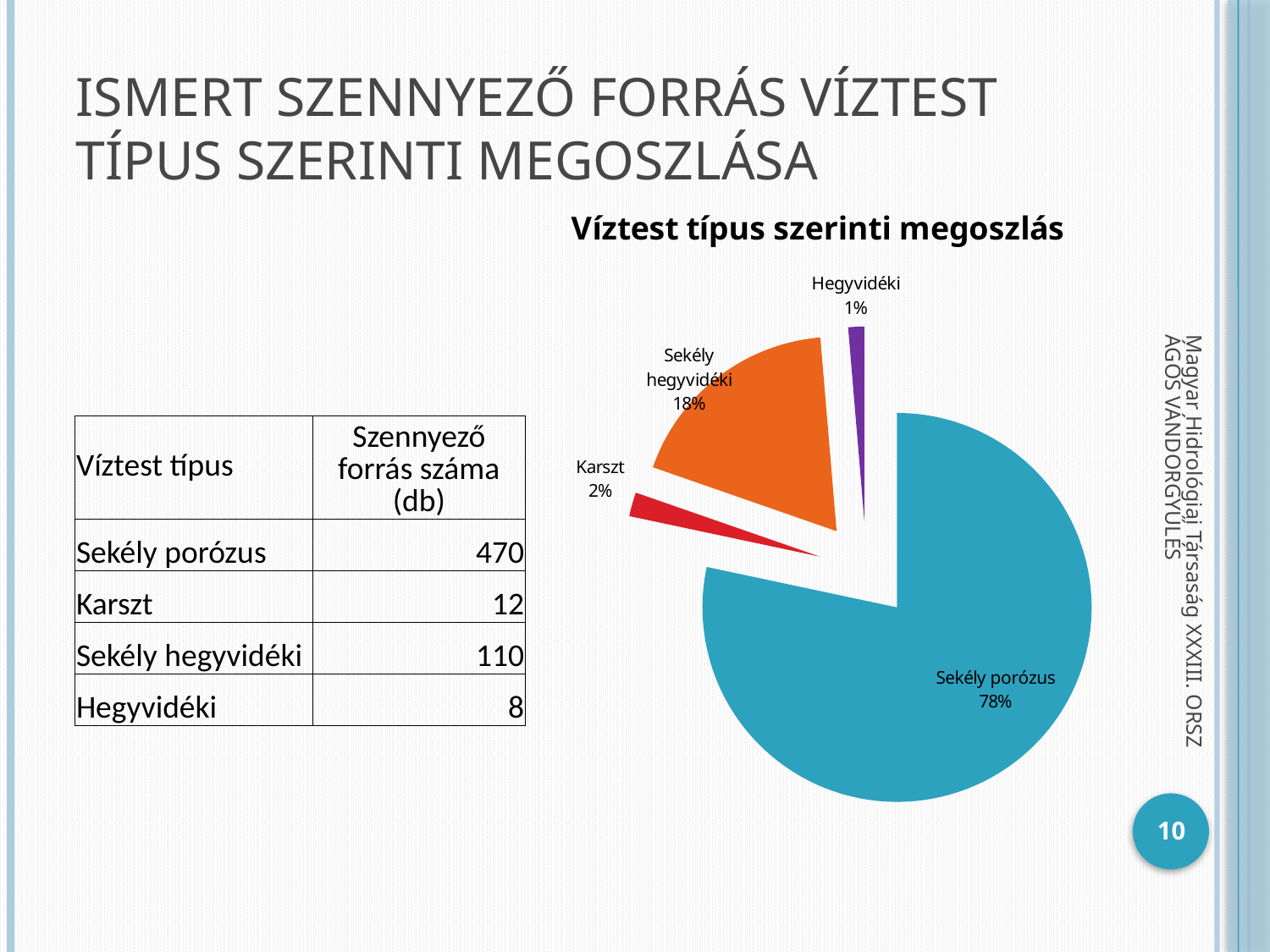
What kind of chart is shown on the slide? pie chart Which category has the smallest slice of the pie? Hegyvidéki Which category has the largest slice of the pie? Sekély porózus What share of the pie does Karszt have? 2% What is the title of the chart? Víztest típus szerinti megoszlás What share of the pie does Sekély hegyvidéki have? 18% Which slice is larger, Sekély hegyvidéki or Karszt? Sekély hegyvidéki What colour is the Sekély porózus slice? blue How many slices does the pie chart have? 4 What share of the pie does Sekély porózus have? 78% What is the difference in percentage points between the Sekély porózus slice and the Sekély hegyvidéki slice? 60